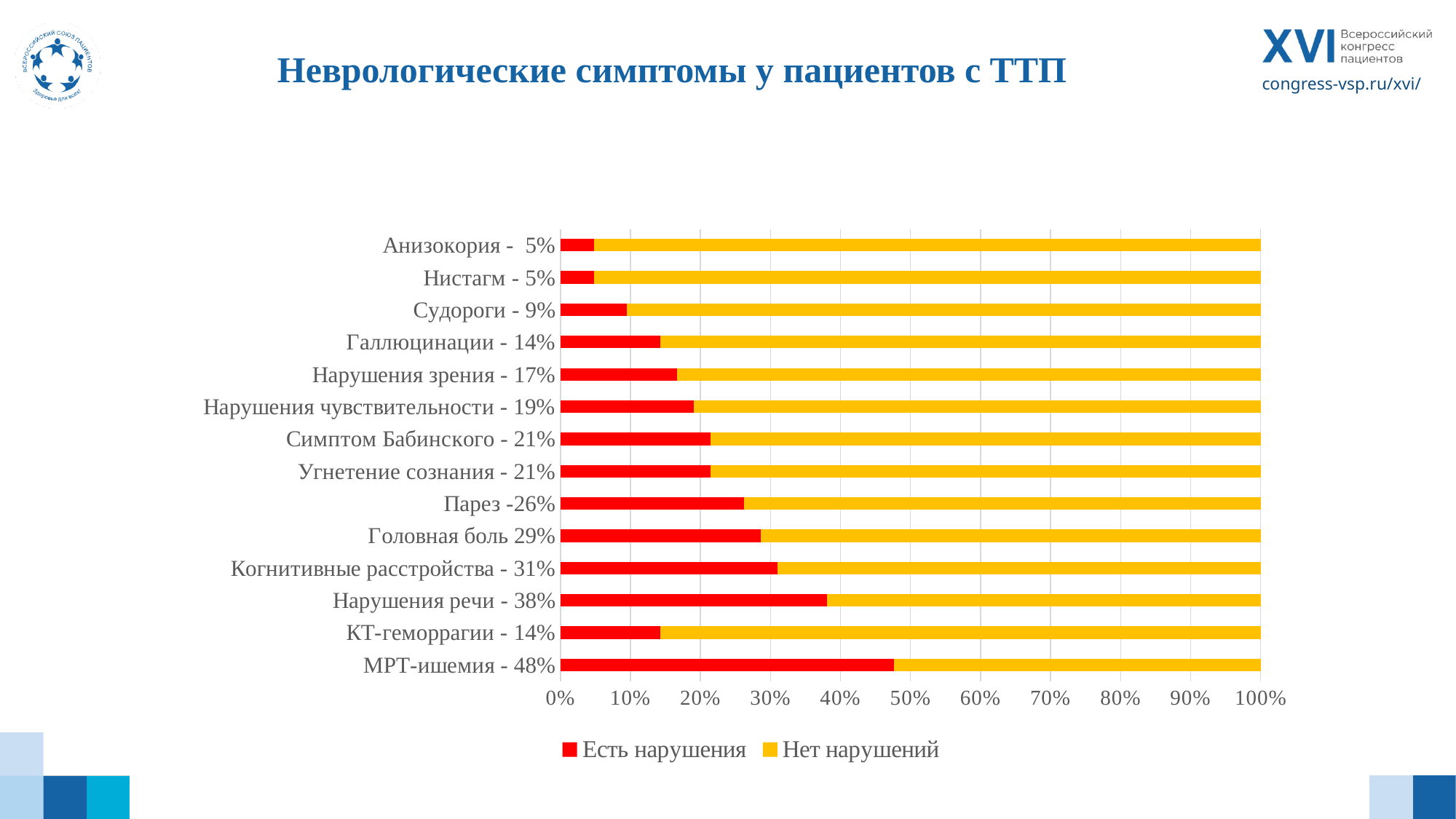
Which category has the highest percentage of 'Есть нарушения'? МРТ-ишемия Which colour represents the 'Есть нарушения' series? red What is the lowest percentage shown among the categories? 5% What is the percentage of patients with 'Есть нарушения' for МРТ-ишемия? 48% What is the percentage for Нарушения речи? 38% Which has a larger percentage, Головная боль or Парез? Головная боль What type of chart is shown on the slide? stacked bar chart What is the title of the chart on the slide? Неврологические симптомы у пациентов с ТТП What is the percentage for Галлюцинации? 14% How many symptom categories are plotted in the chart? 14 How many series does the legend list? 2 What is the difference between the percentages for МРТ-ишемия and Нарушения речи? 10%